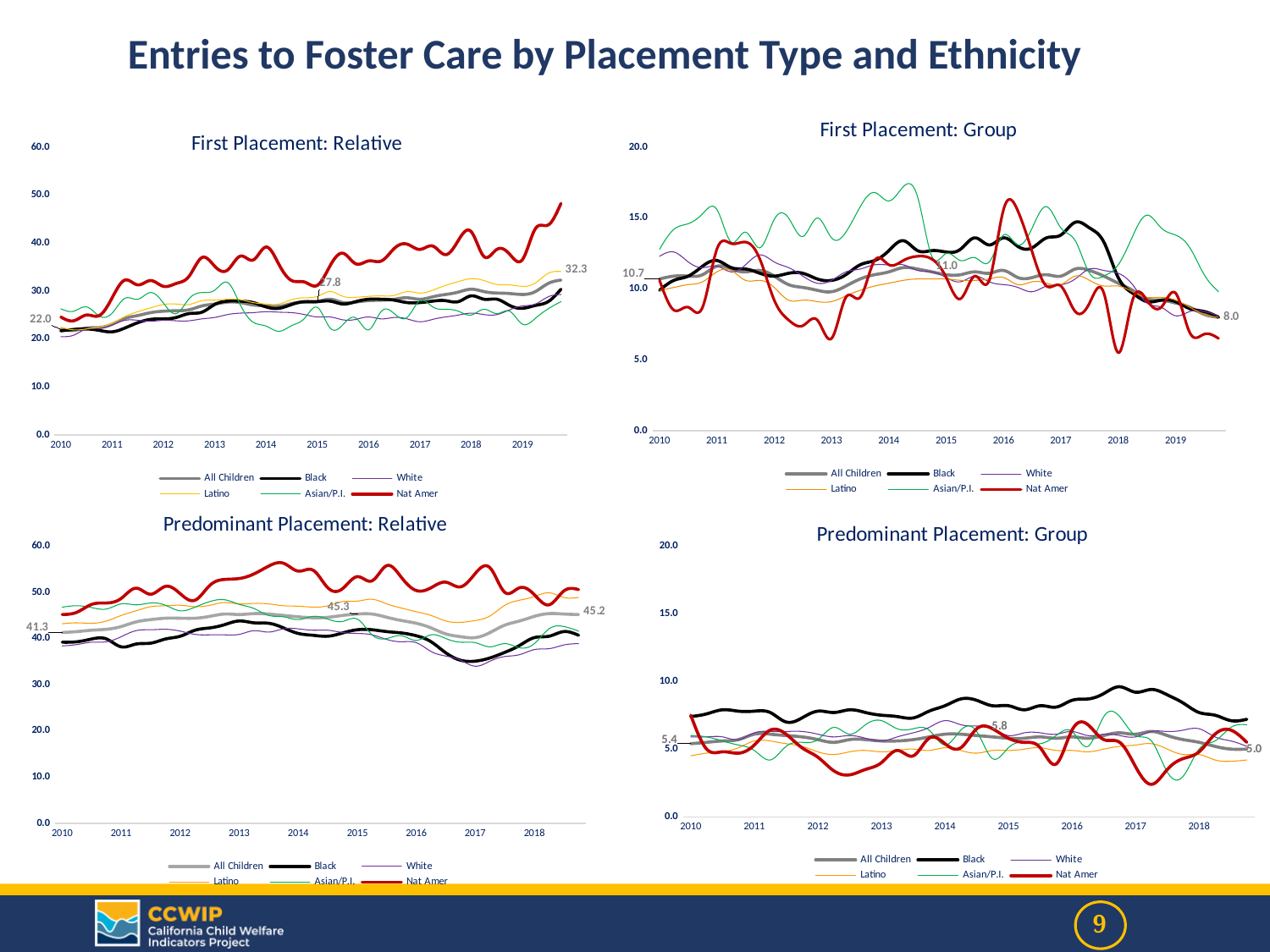
What kind of chart is the "First Placement: Relative" chart? line chart In the "First Placement: Relative" chart, what is the labelled value for All Children at the start of the series in 2010? 22.0 How many series does the legend of the "First Placement: Group" chart list? 6 In the "Predominant Placement: Relative" chart, what is the labelled value for All Children at the start of the series? 41.3 In the "First Placement: Group" chart, does the All Children line end higher or lower than it started (10.7 at the start, 8.0 at the end)? lower In the "Predominant Placement: Relative" chart, what is the difference between the final labelled All Children value (45.2) and the starting labelled value (41.3)? 3.9 In the "First Placement: Group" chart, what is the labelled value for All Children at the end of the series? 8.0 In the "Predominant Placement: Relative" chart, which series is higher in 2014, Nat Amer or All Children? Nat Amer In the "Predominant Placement: Group" chart, what is the labelled value for All Children at the end of the series? 5.0 In the "First Placement: Relative" chart, is the value for Nat Amer at the end of the series greater or less than 40.0? greater In the "First Placement: Relative" chart, what is the labelled value for All Children at the end of the series? 32.3 In the "First Placement: Relative" chart, what is the difference between the final labelled All Children value (32.3) and the starting labelled value (22.0)? 10.3